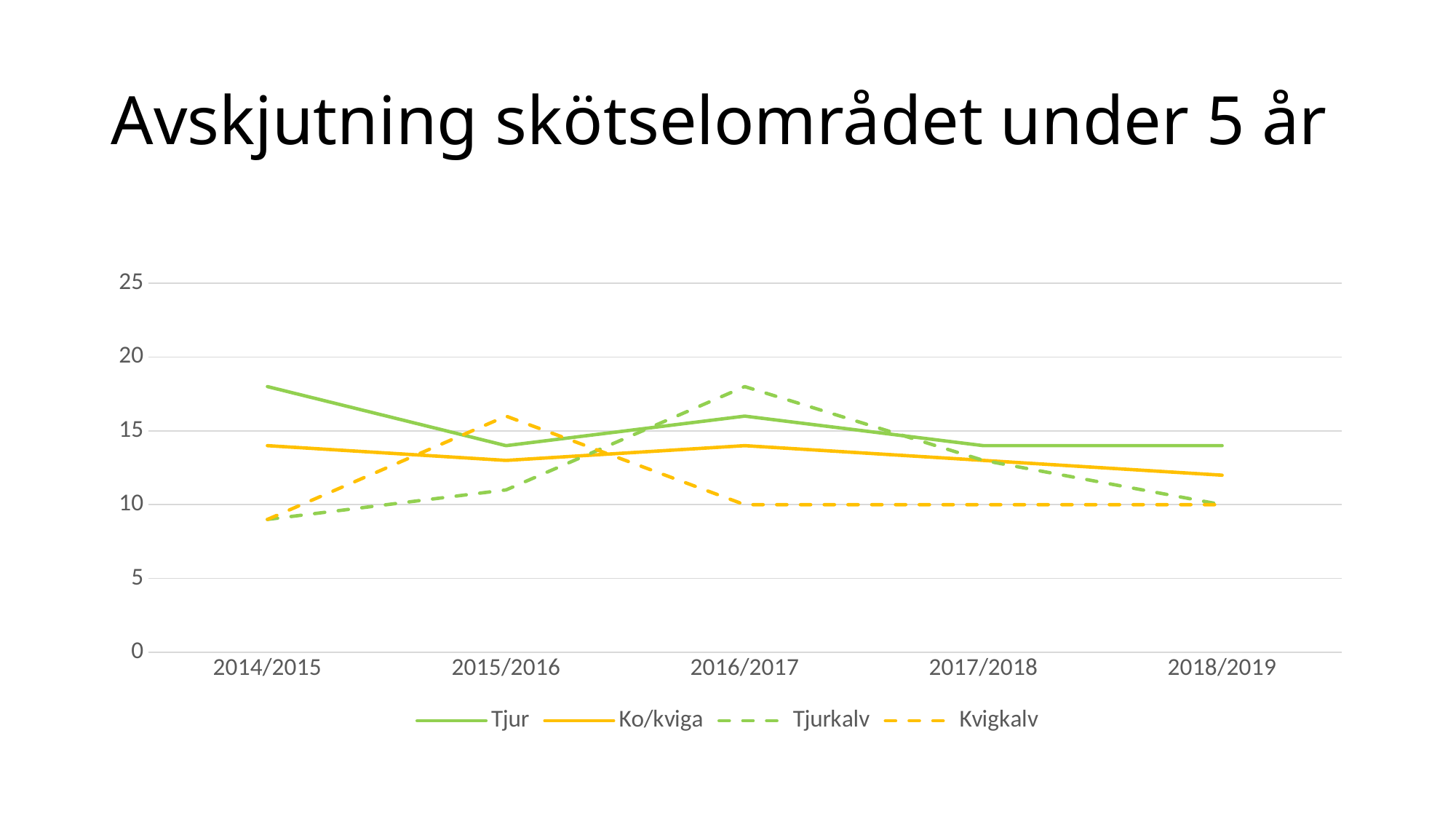
How many series does the legend list? 4 Is the value for Tjurkalv in 2014/2015 greater or less than 10? less How many seasons are shown on the x axis? 5 What is the value for Kvigkalv in 2017/2018? 10 What kind of chart is shown on the slide? line chart What is the title of the chart? Avskjutning skötselområdet under 5 år In 2014/2015, which is larger, Tjur or Ko/kviga? Tjur Which series has the lowest value in 2015/2016? Tjurkalv Is the value for Ko/kviga in 2018/2019 greater or less than 15? less What is the value for Tjurkalv in 2018/2019? 10 Is the value for Tjur in 2014/2015 greater or less than 15? greater Which series has the highest value in 2016/2017? Tjurkalv